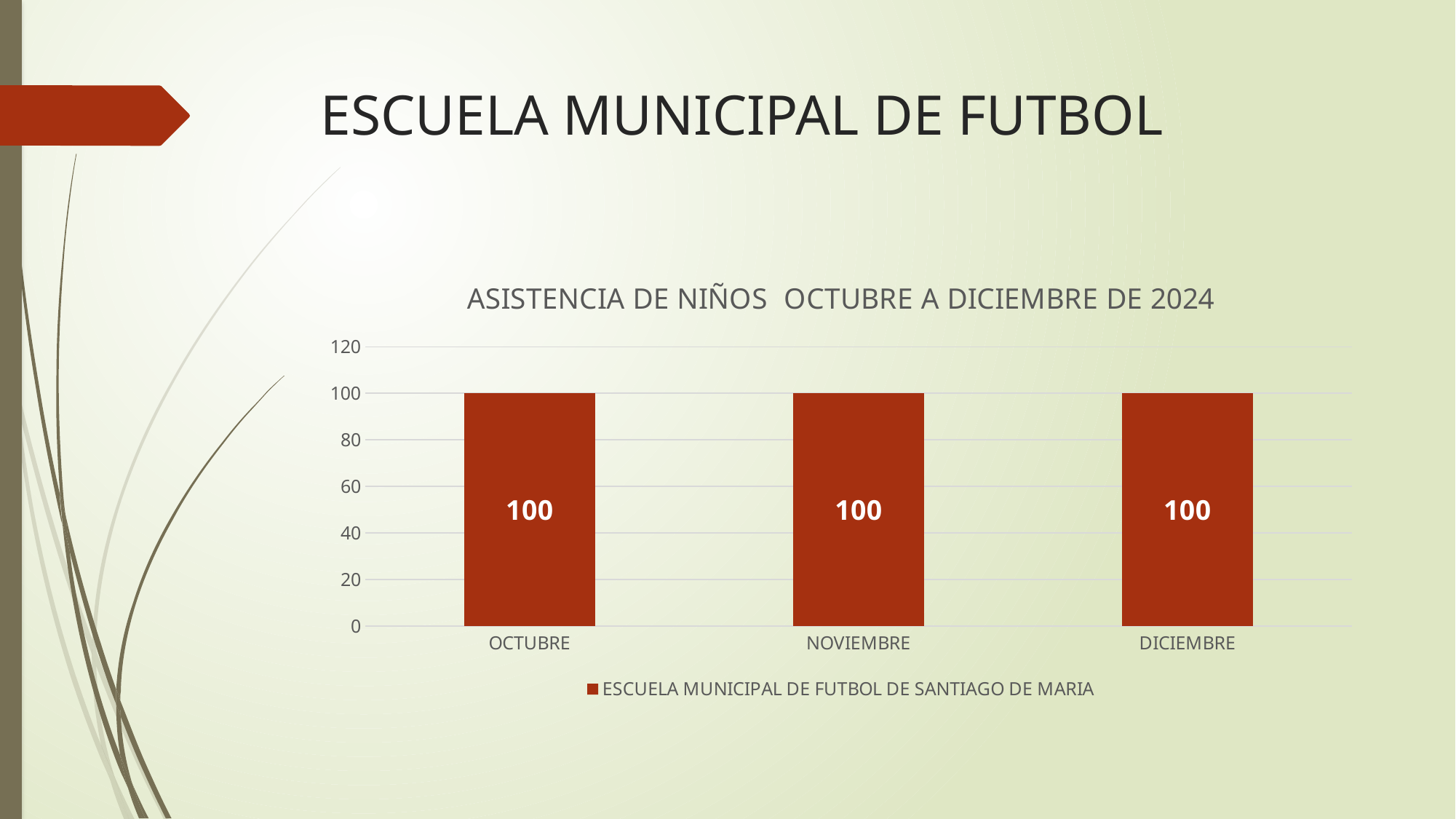
Is the value for DICIEMBRE greater or less than 120? less What is the title of the chart? ASISTENCIA DE NIÑOS OCTUBRE A DICIEMBRE DE 2024 What series name does the legend show? ESCUELA MUNICIPAL DE FUTBOL DE SANTIAGO DE MARIA How many series does the legend list? 1 What is the value for OCTUBRE? 100 What is the value for NOVIEMBRE? 100 How many categories are shown on the x axis? 3 Is the value for NOVIEMBRE greater or less than 80? greater What is the difference between the values for OCTUBRE and DICIEMBRE? 0 What kind of chart is shown? bar chart What is the value for DICIEMBRE? 100 Do the values rise, fall or stay the same from OCTUBRE to DICIEMBRE? stay the same